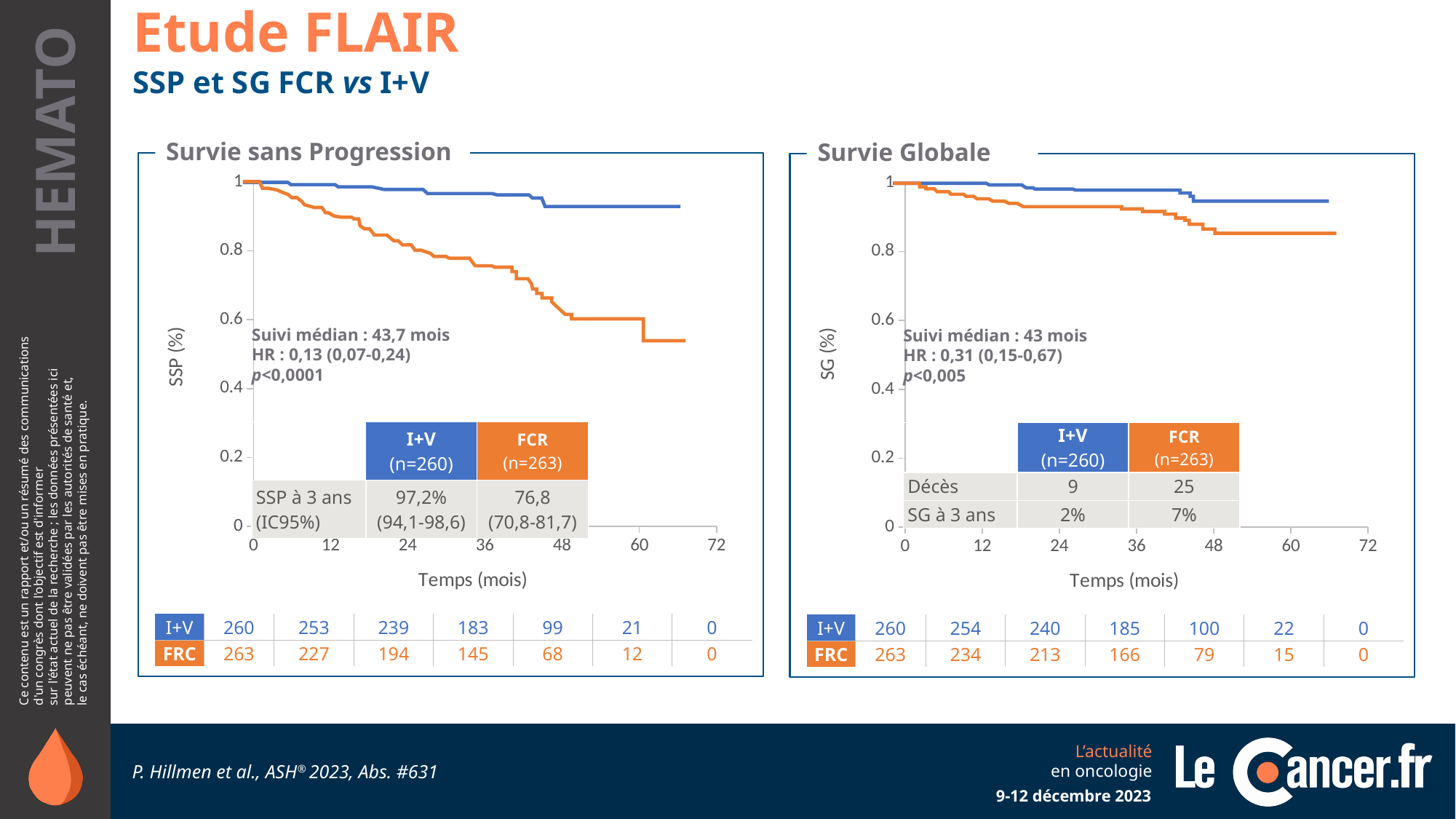
In the "Survie sans Progression" chart, what is the SSP à 3 ans for the I+V arm? 97,2% What kind of chart is shown under "Survie sans Progression"? line chart In the "Survie Globale" chart, what is the median follow-up (Suivi médian)? 43 mois In the "Survie sans Progression" chart, how many I+V patients are at risk at 24 months? 239 In the "Survie Globale" chart, is the I+V curve at 60 months greater or less than 0.8? greater In the "Survie Globale" chart, do the survival curves rise or fall as time increases? fall In the "Survie Globale" chart, how many deaths (Décès) are reported in the FCR arm? 25 In the "Survie sans Progression" chart, which arm has the higher curve at 60 months, I+V or FCR? I+V In the "Survie sans Progression" chart, what is the SSP à 3 ans for the FCR arm? 76,8 In the "Survie sans Progression" chart, what is the hazard ratio (HR) reported? 0,13 (0,07-0,24) In the "Survie Globale" chart, what is the difference in the number of deaths between FCR and I+V? 16 In the "Survie sans Progression" chart, is the FCR curve at 48 months greater or less than 0.8? less